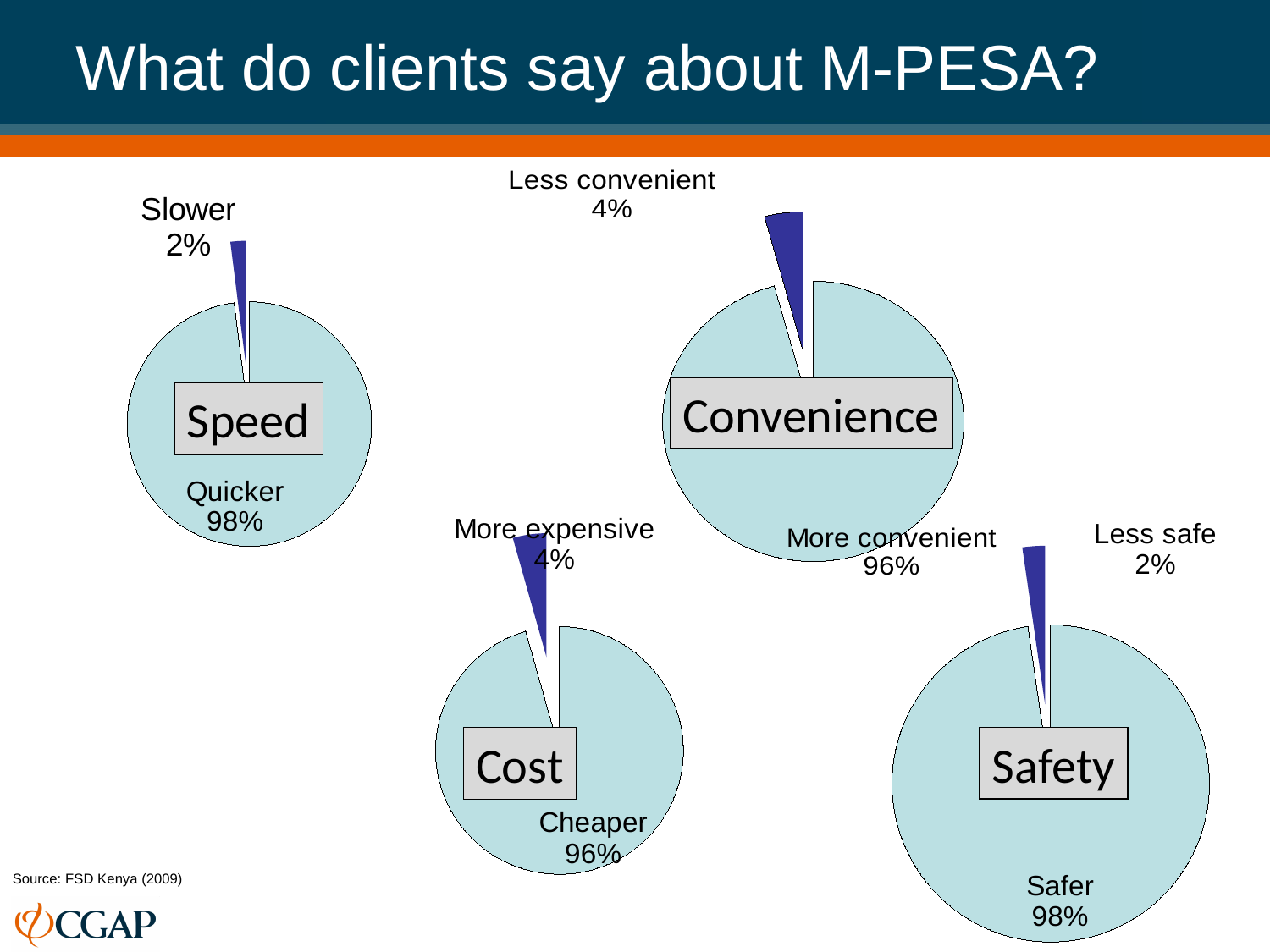
In the Speed pie chart, what share of clients said M-PESA is quicker? 98% In the Speed pie chart, what is the difference between the Quicker and Slower shares? 96% How many pie charts are shown on the slide? 4 In the Cost pie chart, which slice is the smallest? More expensive In the Convenience pie chart, what share of clients said M-PESA is less convenient? 4% In the Convenience pie chart, what share of clients said M-PESA is more convenient? 96% In the Cost pie chart, what share of clients said M-PESA is cheaper? 96% In the Safety pie chart, what share of clients said M-PESA is less safe? 2% Which is larger: the Less convenient share in the Convenience chart or the Less safe share in the Safety chart? Less convenient What kind of chart is used for Speed, Convenience, Cost and Safety on this slide? Pie chart In the Safety pie chart, which slice is the largest? Safer In the Speed pie chart, what share of clients said M-PESA is slower? 2%